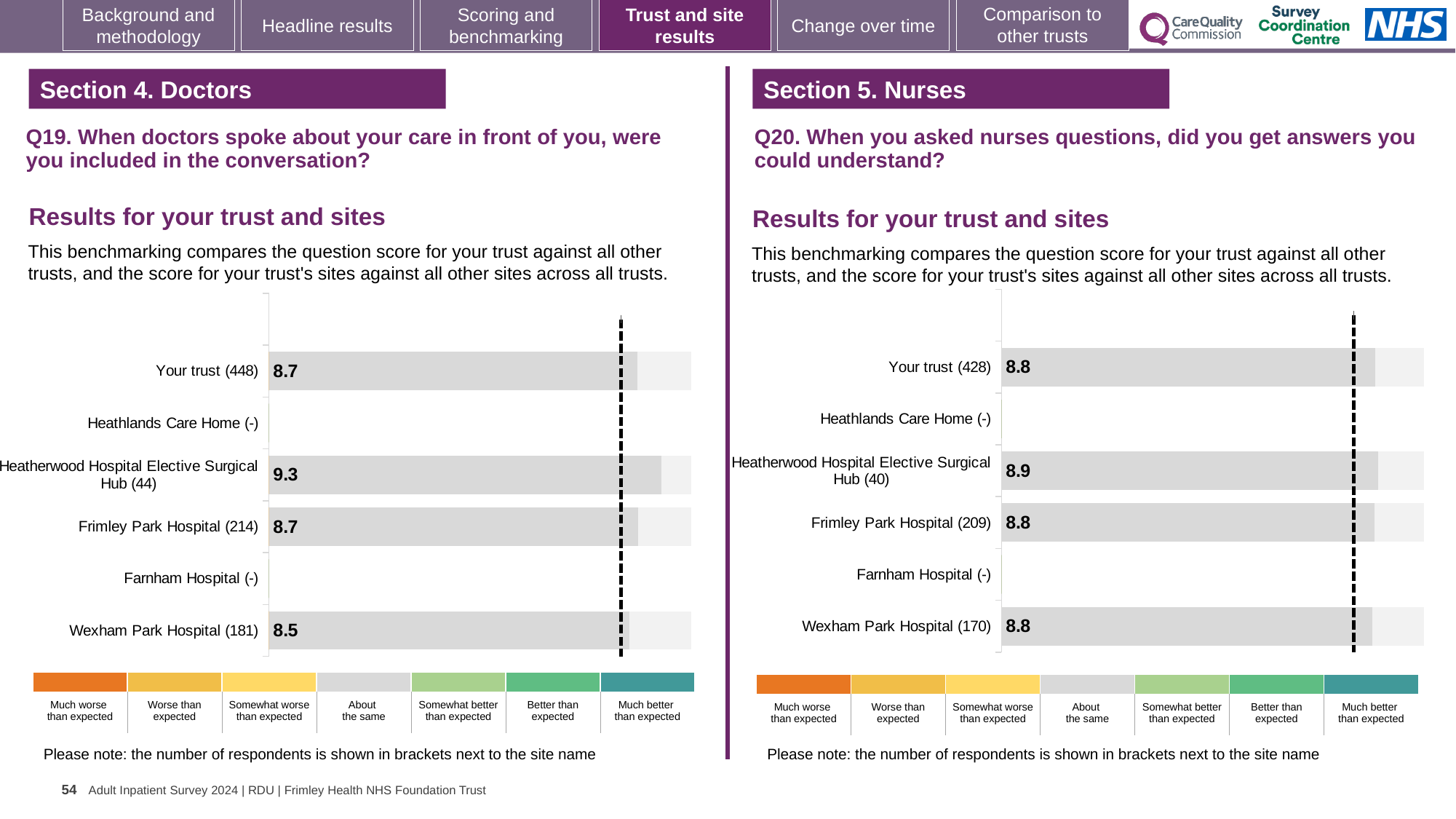
On the Q19 chart (left), which site with a score shown has the lowest score? Wexham Park Hospital On the Q19 chart (left), what is the difference between the scores for Heatherwood Hospital Elective Surgical Hub and Wexham Park Hospital? 0.8 On the Q20 chart (right), which site has the highest score? Heatherwood Hospital Elective Surgical Hub What kind of chart is the Q20 chart (right)? Bar chart On the Q19 chart (left), which has the larger score: Frimley Park Hospital or Wexham Park Hospital? Frimley Park Hospital On the Q20 chart (right), what is the difference between the scores for Heatherwood Hospital Elective Surgical Hub and Frimley Park Hospital? 0.1 On the Q20 chart (right), what is the score for Wexham Park Hospital? 8.8 On the Q19 chart (left), which site has the highest score? Heatherwood Hospital Elective Surgical Hub On the Q19 chart (left), what is the score for Heatherwood Hospital Elective Surgical Hub? 9.3 On the Q20 chart (right), what is the score for Your trust? 8.8 How many site rows are listed on the Q19 chart (left)? 6 On the Q19 chart (left), what is the score for Your trust? 8.7